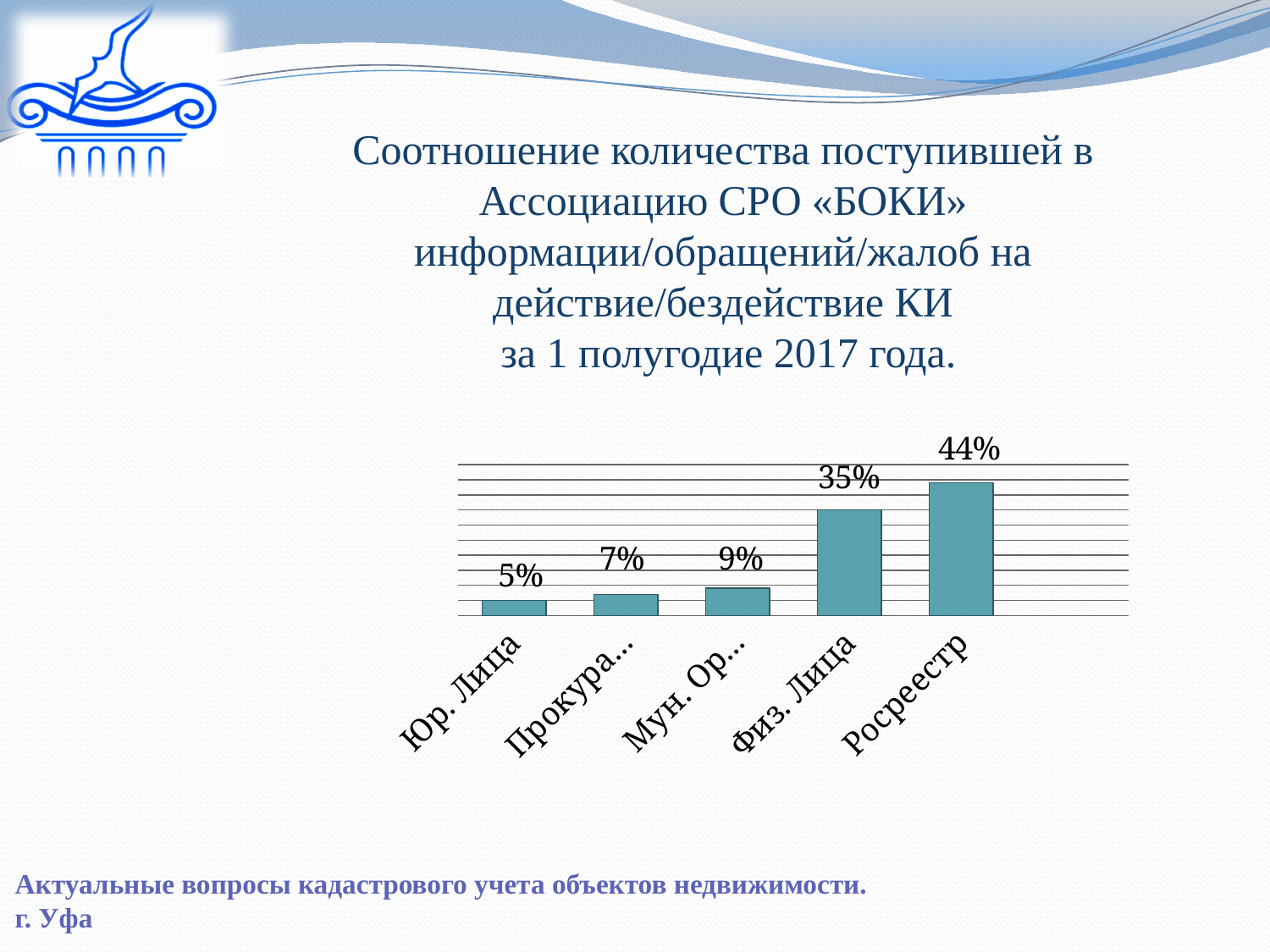
What is the value for Юр. Лица? 5% Which category has the lowest value? Юр. Лица Do the values rise or fall from left to right along the x axis? rise What is the value for Физ. Лица? 35% Which category has the highest value? Росреестр What is the value for the category labelled "Прокура..."? 7% What is the value for the category labelled "Мун. Ор..."? 9% How many categories are shown in the chart? 5 What kind of chart is shown on the slide? bar chart What is the difference between the values for Росреестр and Физ. Лица? 9% What is the value for Росреестр? 44% Which is larger, the value for Физ. Лица or the value for Юр. Лица? Физ. Лица